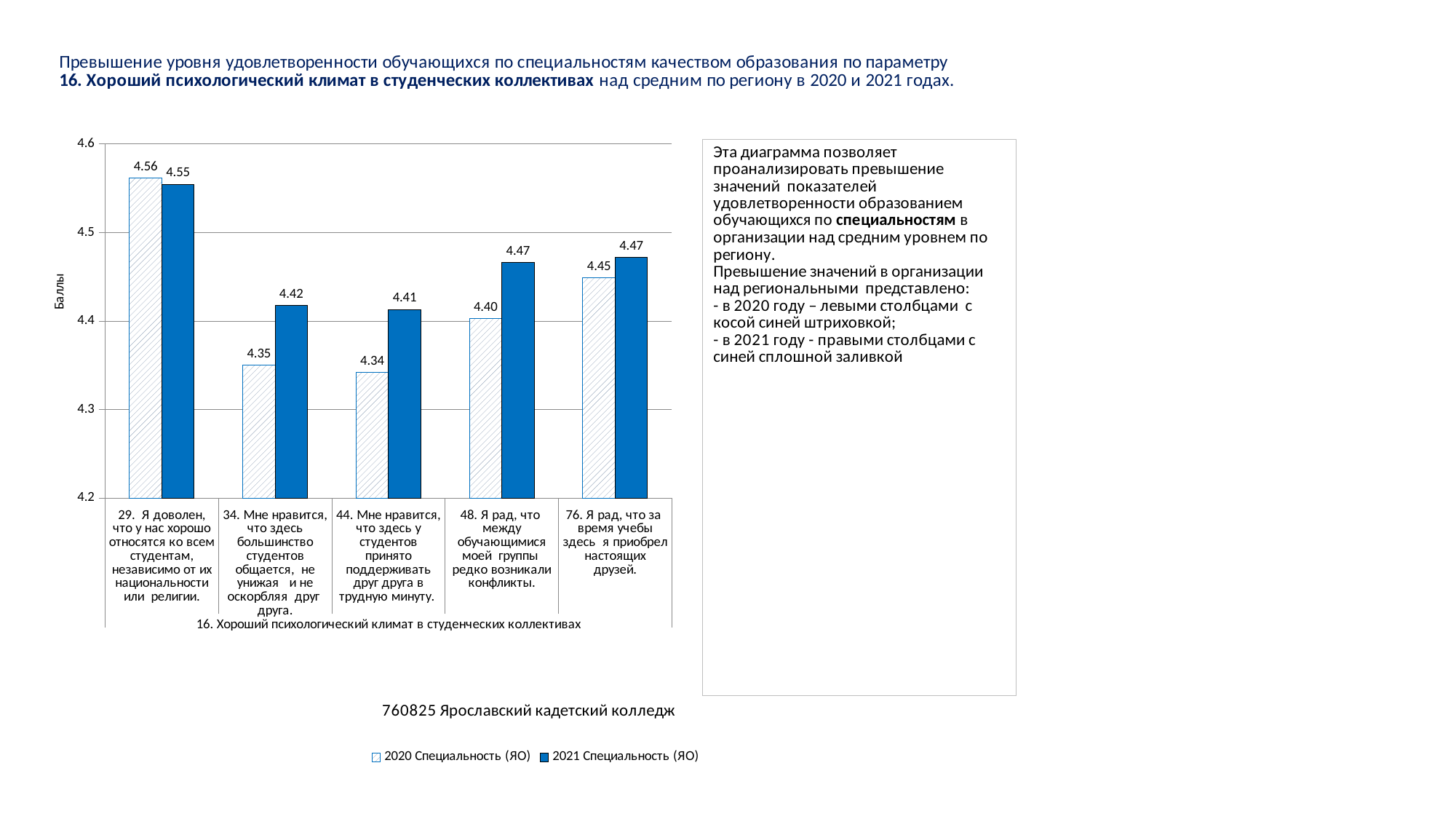
What is the 2020 value for statement 48 ("Я рад, что между обучающимися моей группы редко возникали конфликты")? 4.40 By how much did the value for statement 34 increase from 2020 to 2021? 0.07 What type of chart is shown on the slide? bar chart What is the 2020 value for statement 29 ("Я доволен, что у нас хорошо относятся ко всем студентам...")? 4.56 How many series does the legend list? 2 Is the 2020 value for statement 44 greater or less than 4.4? less Which statement has the highest 2020 value? 29. Я доволен, что у нас хорошо относятся ко всем студентам, независимо от их национальности или религии. How many statements (categories) are shown on the x axis? 5 What is the label of the vertical axis? Баллы For statement 76 ("Я рад, что за время учебы здесь я приобрел настоящих друзей"), which year has the larger value, 2020 or 2021? 2021 What is the 2021 value for statement 34 ("Мне нравится, что здесь большинство студентов общается, не унижая и не оскорбляя друг друга")? 4.42 Which statement has the lowest 2021 value? 44. Мне нравится, что здесь у студентов принято поддерживать друг друга в трудную минуту.